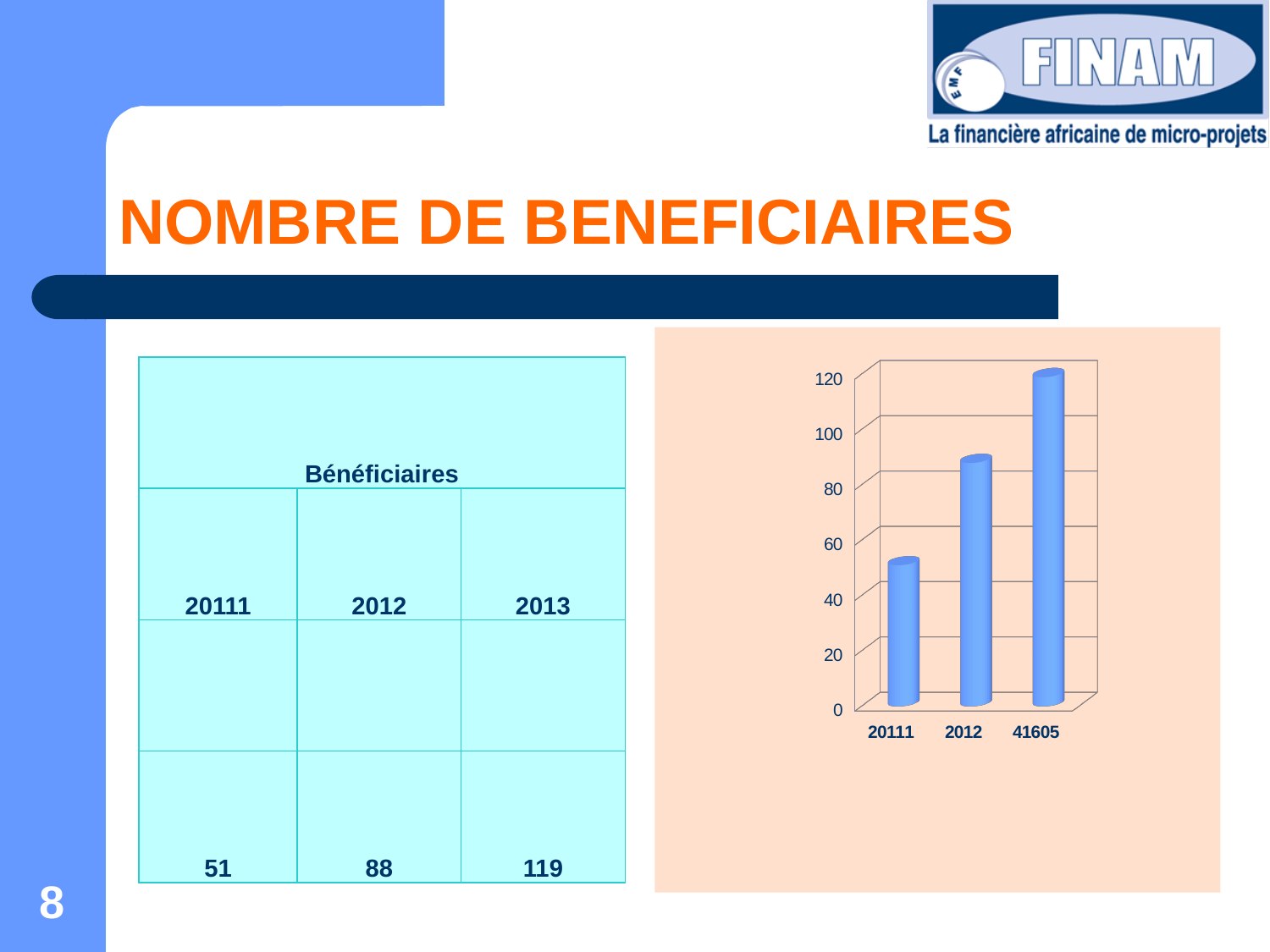
How many bars does the chart show? 3 Is the value for 20111 greater or less than 60? less Which category has the highest bar in the chart? 41605 Is the value for 2012 greater or less than 100? less What kind of chart is shown on the slide? bar chart What is the highest value shown on the chart's vertical axis? 120 Is the value for 41605 greater or less than 100? greater Which is larger in the chart, the bar for 2012 or the bar for 20111? 2012 Do the bar values rise or fall from left to right along the x axis? rise Which category has the lowest bar in the chart? 20111